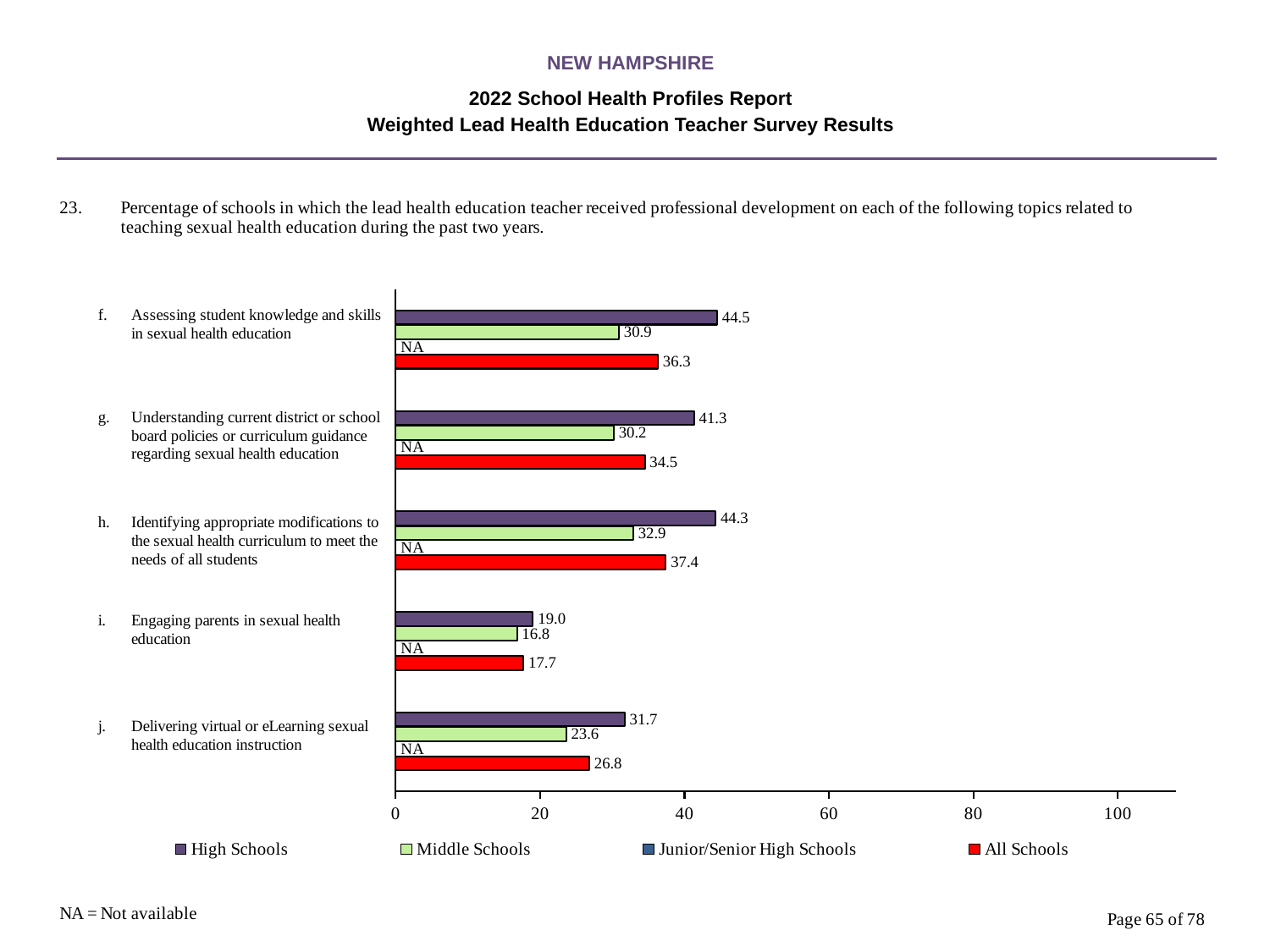
What is the difference between the High Schools and Middle Schools values for 'Identifying appropriate modifications to the sexual health curriculum to meet the needs of all students'? 11.4 Is the All Schools value for 'Identifying appropriate modifications to the sexual health curriculum to meet the needs of all students' greater or less than 40? less What is the value for All Schools for 'Delivering virtual or eLearning sexual health education instruction'? 26.8 How many series does the legend list? 4 What is the value for High Schools for 'Assessing student knowledge and skills in sexual health education'? 44.5 Which topic has the lowest All Schools value? Engaging parents in sexual health education Which topic has the highest High Schools value? Assessing student knowledge and skills in sexual health education How many topics (categories) are shown in the chart? 5 What kind of chart is shown on the slide? bar chart What value is shown for Junior/Senior High Schools for each topic? NA Which is larger for 'Understanding current district or school board policies or curriculum guidance regarding sexual health education': the High Schools value or the All Schools value? High Schools What is the value for Middle Schools for 'Engaging parents in sexual health education'? 16.8